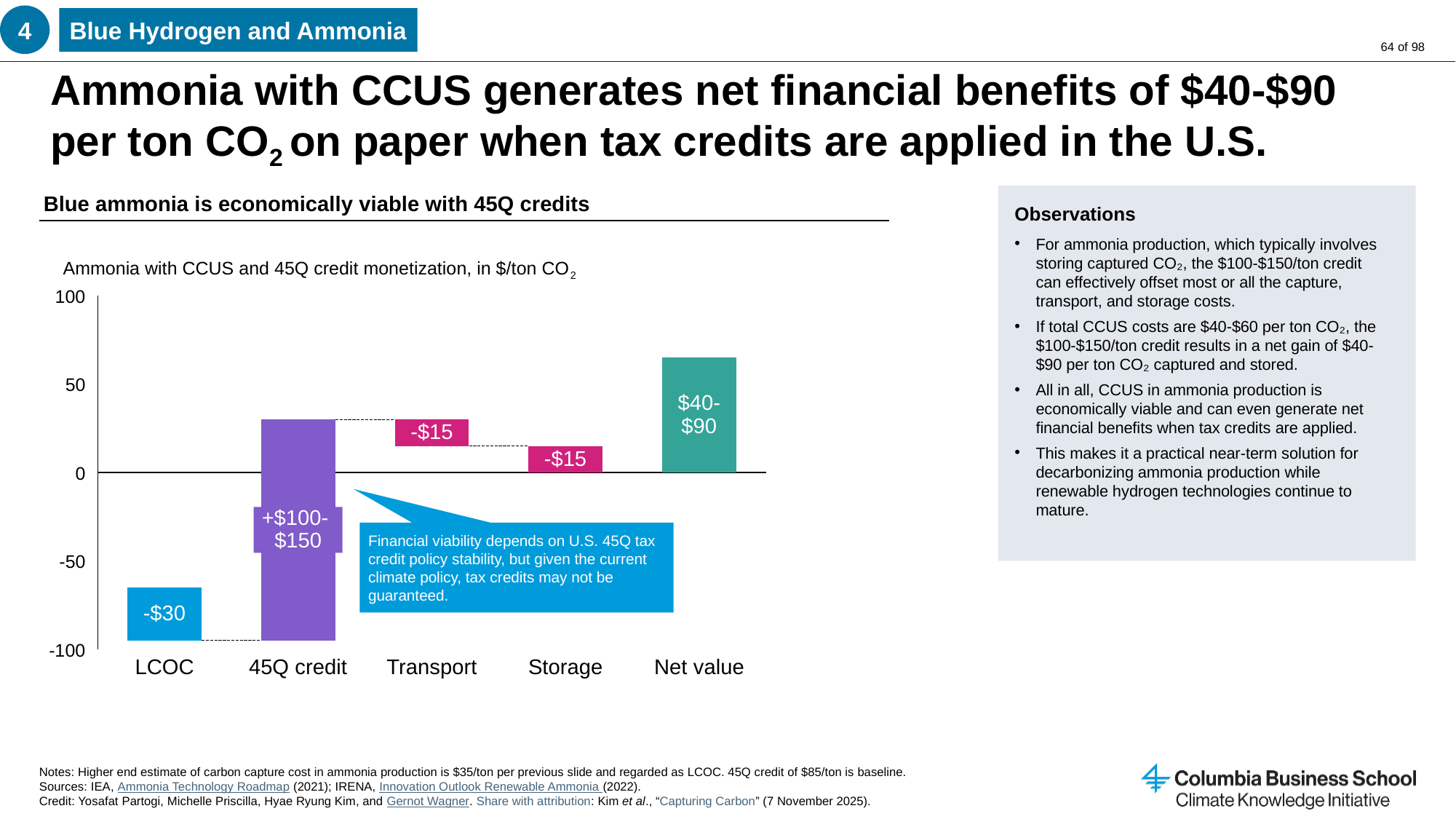
What is the value shown for Transport? -$15 What is the difference between the LCOC value and the Transport value? $15 What is the value shown for Storage? -$15 What is the value shown for LCOC? -$30 What kind of chart is shown on the slide? Bar chart (waterfall) What is the value shown for Net value? $40-$90 What is the unit stated in the chart's title? $/ton CO2 Which category has the largest positive value? 45Q credit Which category has the largest cost (most negative value)? LCOC What is the value shown for the 45Q credit? +$100-$150 How many categories are shown on the x axis of the chart? 5 What is the combined cost of Transport and Storage? -$30